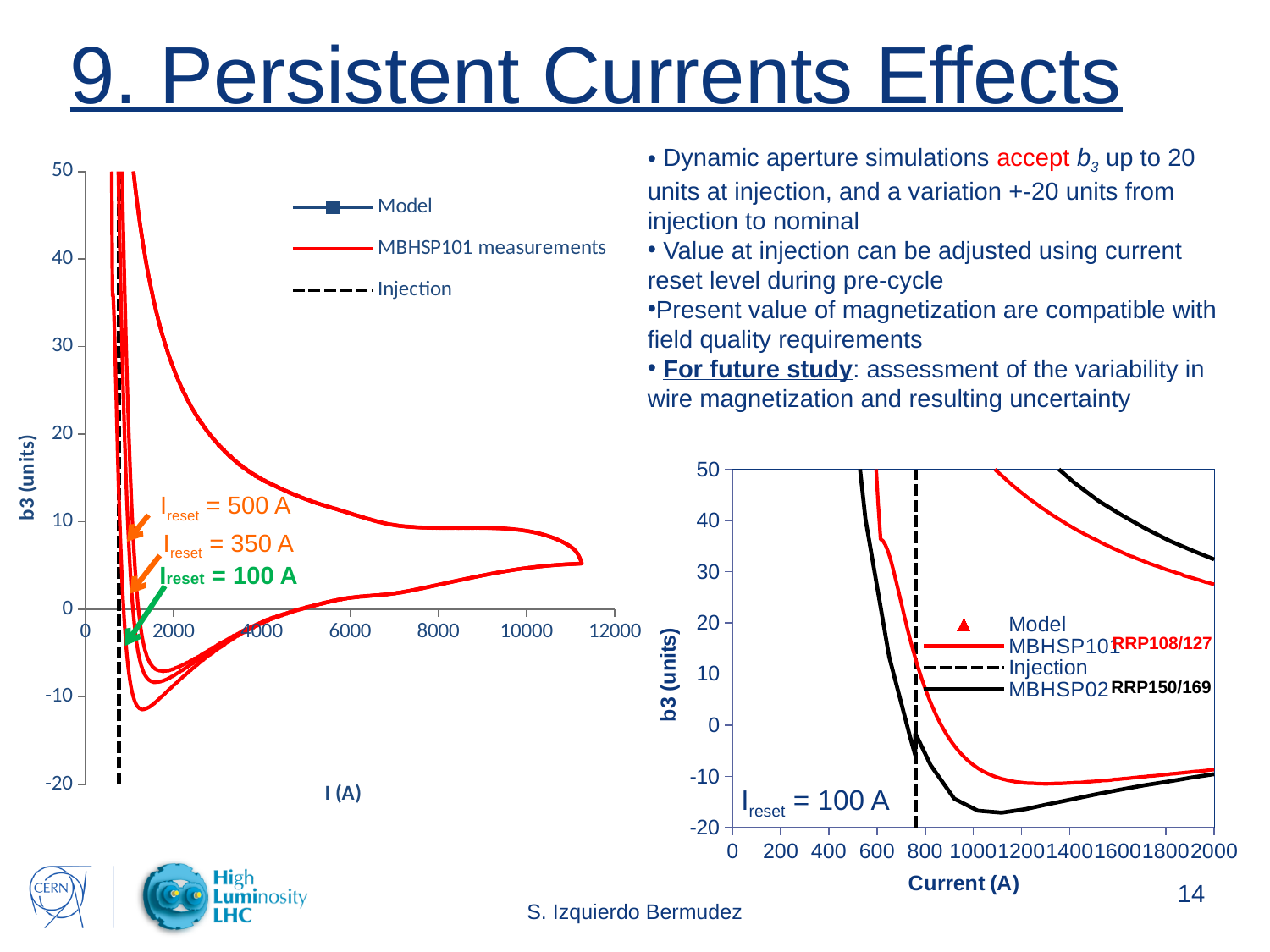
What kind of chart is the right chart with x axis 'Current (A)'? line chart In the left chart, what is the highest value shown on the x axis? 12000 In the right chart, is the minimum value of the MBHSP02 curve greater or less than -10? less What kind of chart is the left chart with x axis 'I (A)'? line chart In the left chart, what is the label of the y axis? b3 (units) In the right chart, what is the label of the x axis? Current (A) In the right chart, at 2000 A, which curve has the higher b3 value, MBHSP02 or MBHSP101? MBHSP02 How many series does the legend of the left chart list? 3 How many series does the legend of the right chart list? 4 In the right chart, is the minimum value of the MBHSP101 curve greater or less than 0? less